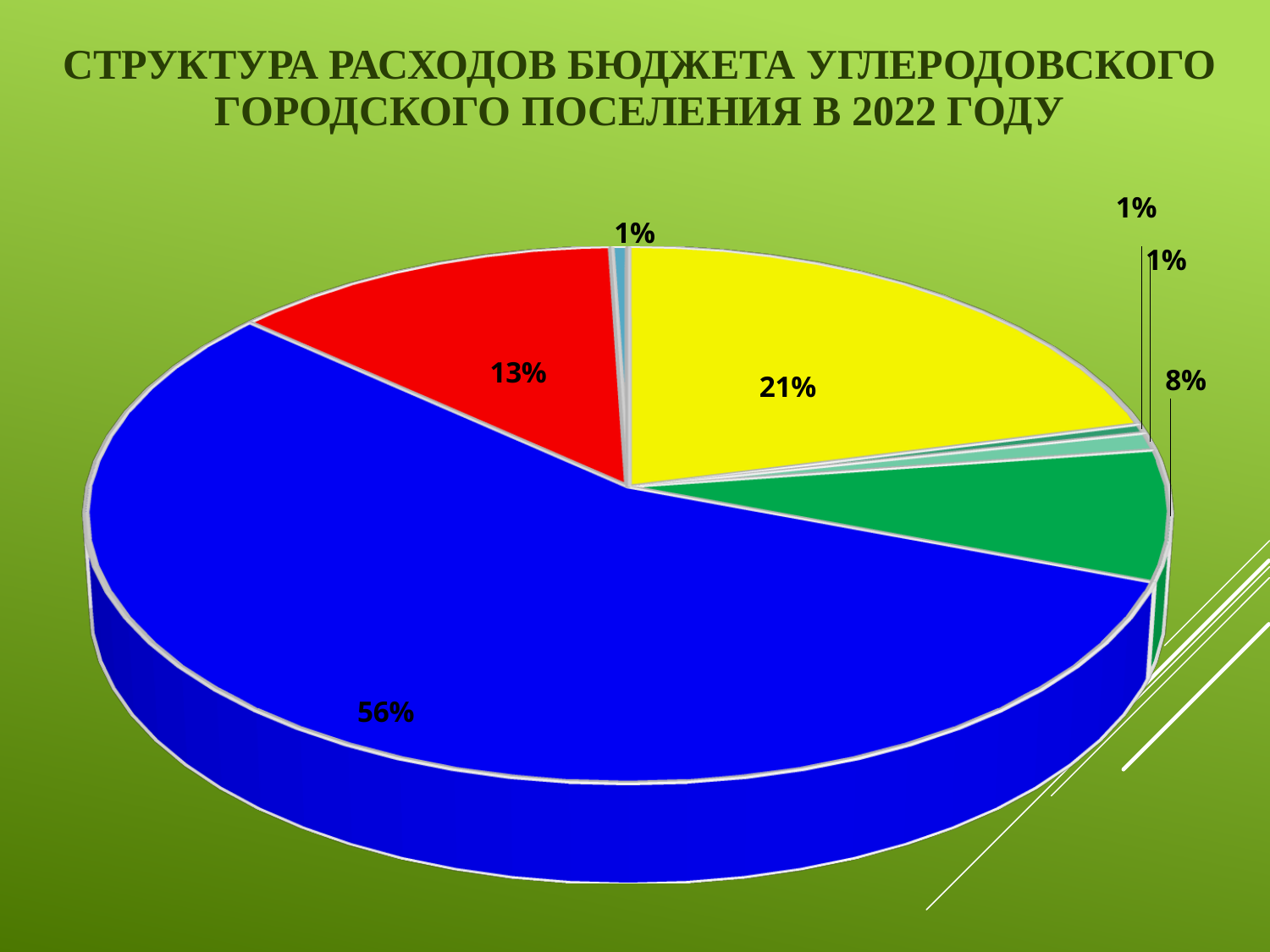
Which slice of the pie is the largest? The blue slice (56%) What is the title of the chart? СТРУКТУРА РАСХОДОВ БЮДЖЕТА УГЛЕРОДОВСКОГО ГОРОДСКОГО ПОСЕЛЕНИЯ В 2022 ГОДУ What is the difference between the yellow slice and the red slice? 8 percentage points What share of the pie does the dark green slice represent? 8% What share of the pie does the blue slice represent? 56% By how many percentage points does the blue slice exceed the yellow slice? 35 percentage points What share of the pie does the red slice represent? 13% What kind of chart is shown on the slide? Pie chart Which is larger, the red slice or the dark green slice? The red slice How many slices does the pie chart have? 7 How many slices are labelled 1%? 3